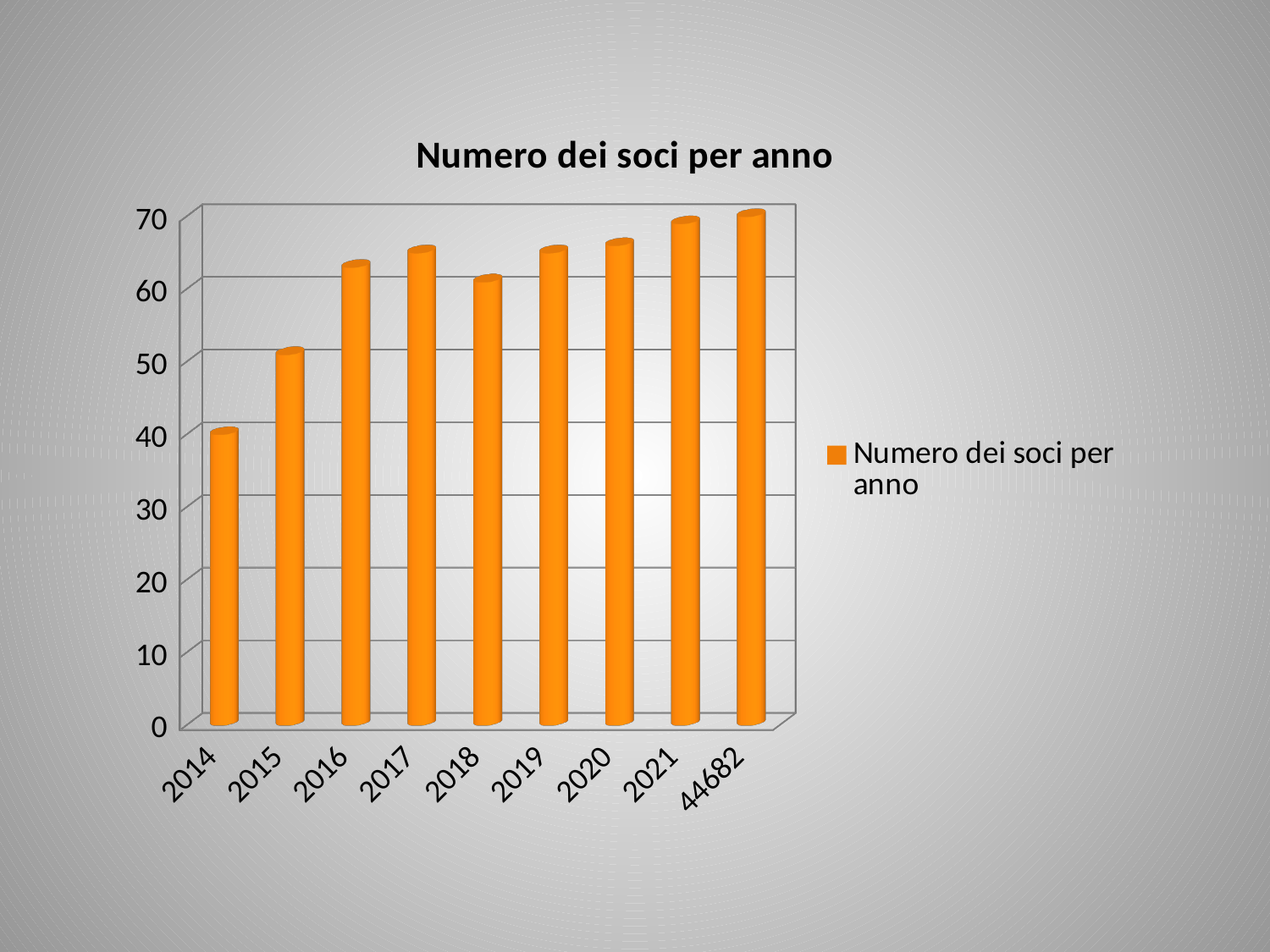
Which is larger, the value for 2015 or the value for 2016? 2016 What kind of chart is shown on the slide? Bar chart Is the value for 2015 greater or less than 60? less How many series does the legend list? 1 Is the value for 2021 greater or less than 60? greater Which category has the lowest value? 2014 Which is larger, the value for 2017 or the value for 2018? 2017 Is the value for 2014 greater or less than 50? less How many categories are shown on the x axis? 9 What is the title of the chart? Numero dei soci per anno Do the values generally rise or fall from 2014 to the last category? rise